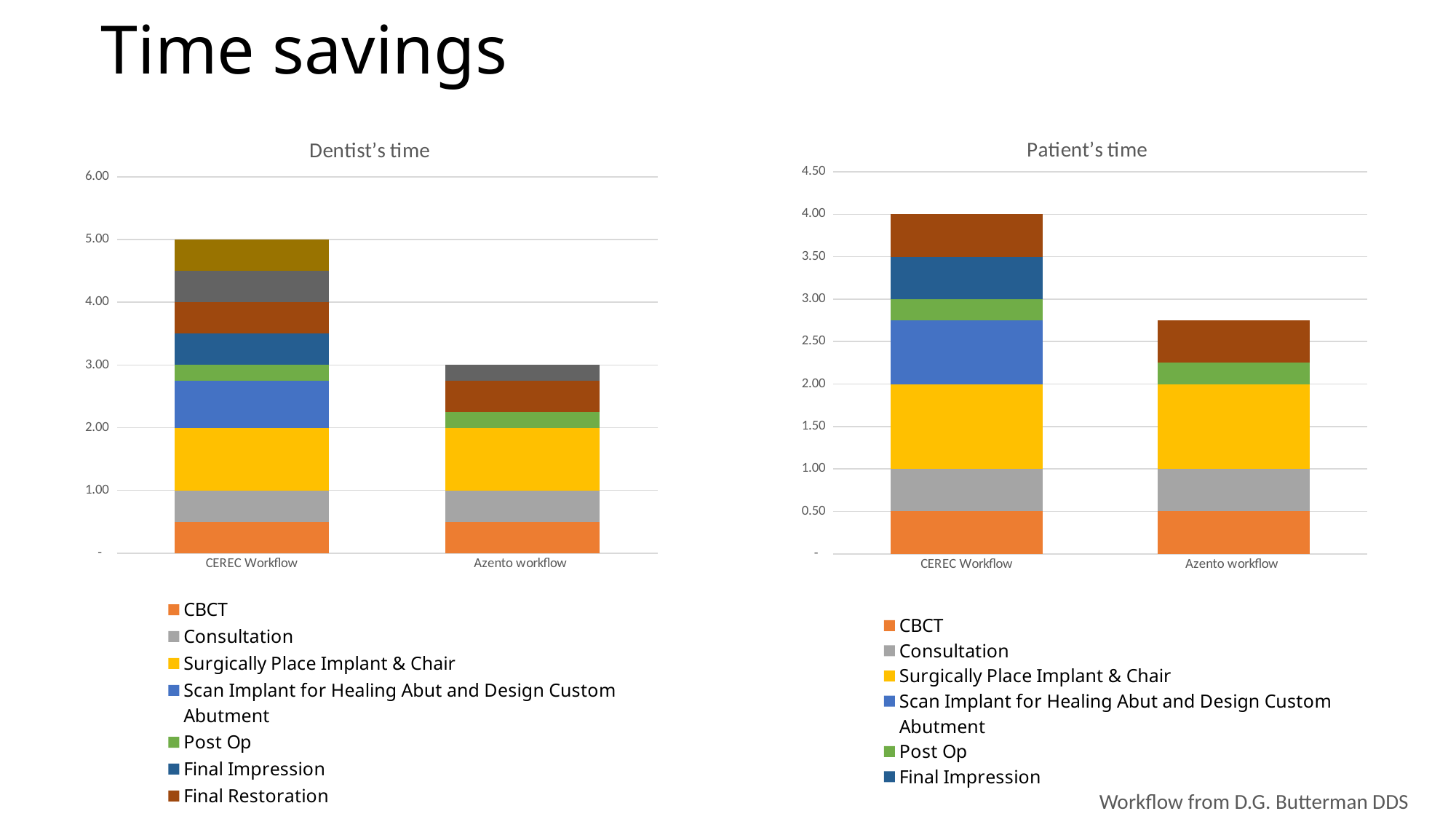
In the "Patient's time" chart, is the total for Azento workflow greater or less than 3.00? less In the "Patient's time" chart, what is the total height of the CEREC Workflow bar? 4.00 How many series does the legend of the "Dentist's time" chart list? 7 In the "Dentist's time" chart, what is the difference between the CEREC Workflow total and the Azento workflow total? 2.00 How many workflow categories are shown on the x axis of the "Patient's time" chart? 2 What kind of chart is the "Dentist's time" chart? Stacked bar chart In the "Dentist's time" chart, which workflow has the taller bar? CEREC Workflow In the "Dentist's time" chart, what is the total height of the CEREC Workflow bar? 5.00 In the "Patient's time" chart, what colour represents CBCT in the legend? Orange In the "Dentist's time" chart, what is the total height of the Azento workflow bar? 3.00 In the "Patient's time" chart, which bar is shorter, CEREC Workflow or Azento workflow? Azento workflow In the "Patient's time" chart, is the total for Azento workflow greater or less than 2.50? greater